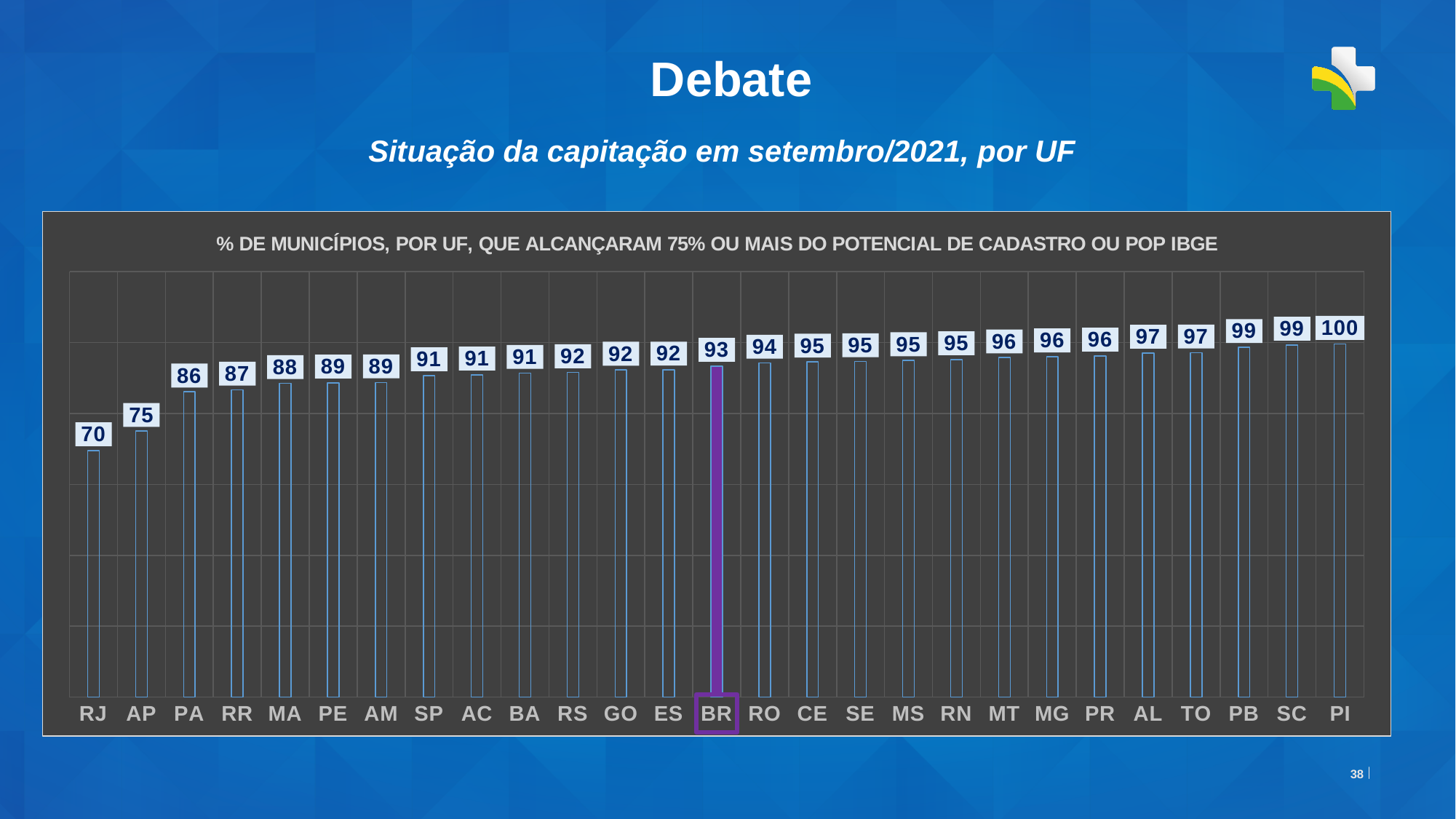
What is the value for RJ? 70 What is the value for BR? 93 Which UF has the highest value? PI Which UF has the lowest value? RJ What is the difference between the values for PI and RJ? 30 Which category's bar is highlighted in purple? BR Which is larger, the value for PA or the value for MT? MT What kind of chart is this? bar chart How many UF categories are shown on the x axis? 27 Do the values rise or fall from left to right along the x axis? rise What is the value for MA? 88 What is the difference between the values for BR and AP? 18